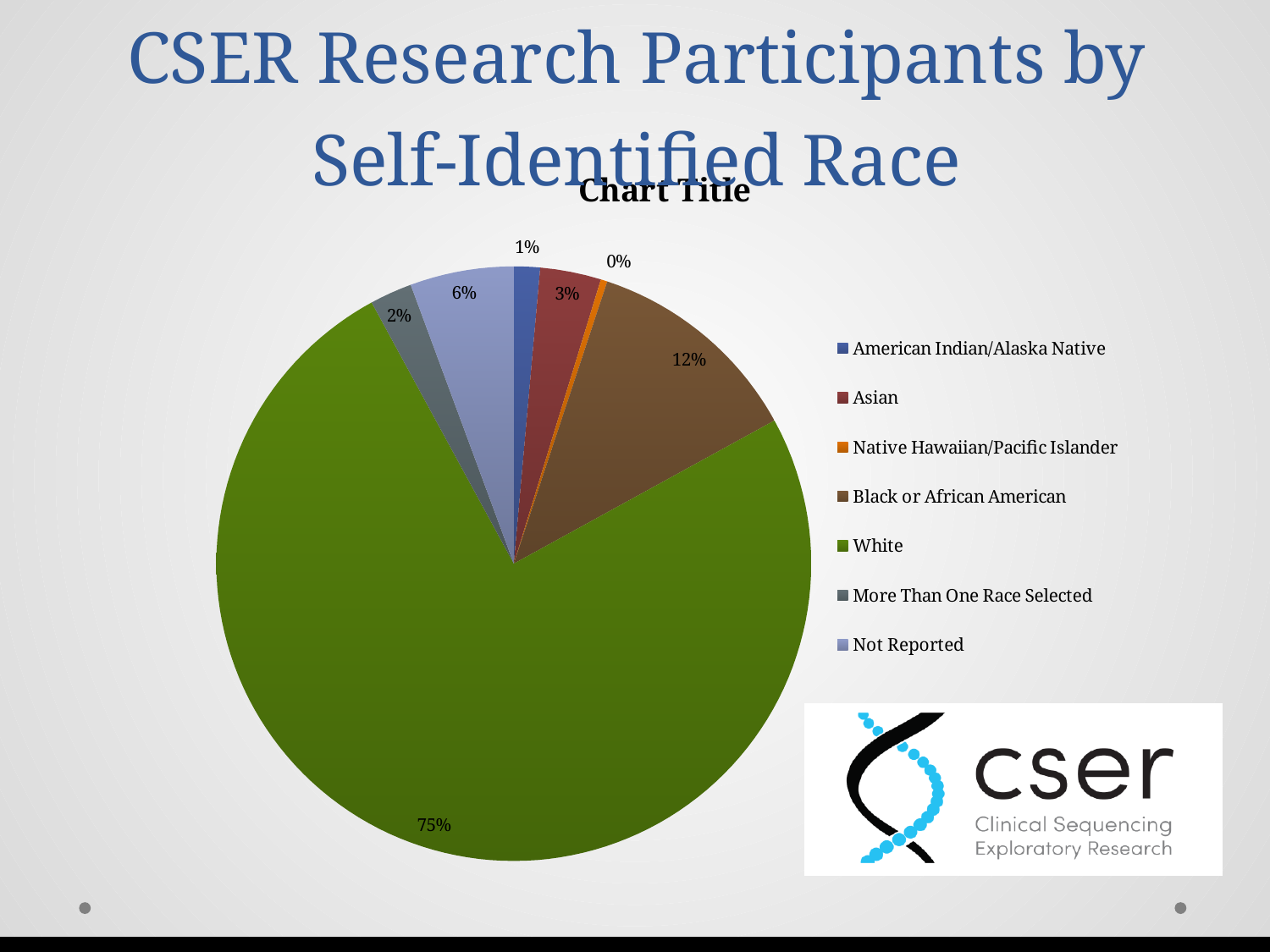
Which race category has the largest share of the pie? White What percentage of participants self-identified as American Indian/Alaska Native? 1% Which is larger, the Not Reported slice or the Asian slice? Not Reported How many race categories does the legend list? 7 What type of chart is shown on the slide? pie chart What is the difference in percentage points between the White and Black or African American slices? 63 What percentage of participants did not report their race? 6% What percentage of participants selected more than one race? 2% What percentage of participants self-identified as Asian? 3% What percentage of participants self-identified as Black or African American? 12% Which race category has the smallest share of the pie? Native Hawaiian/Pacific Islander What percentage of CSER research participants self-identified as White? 75%